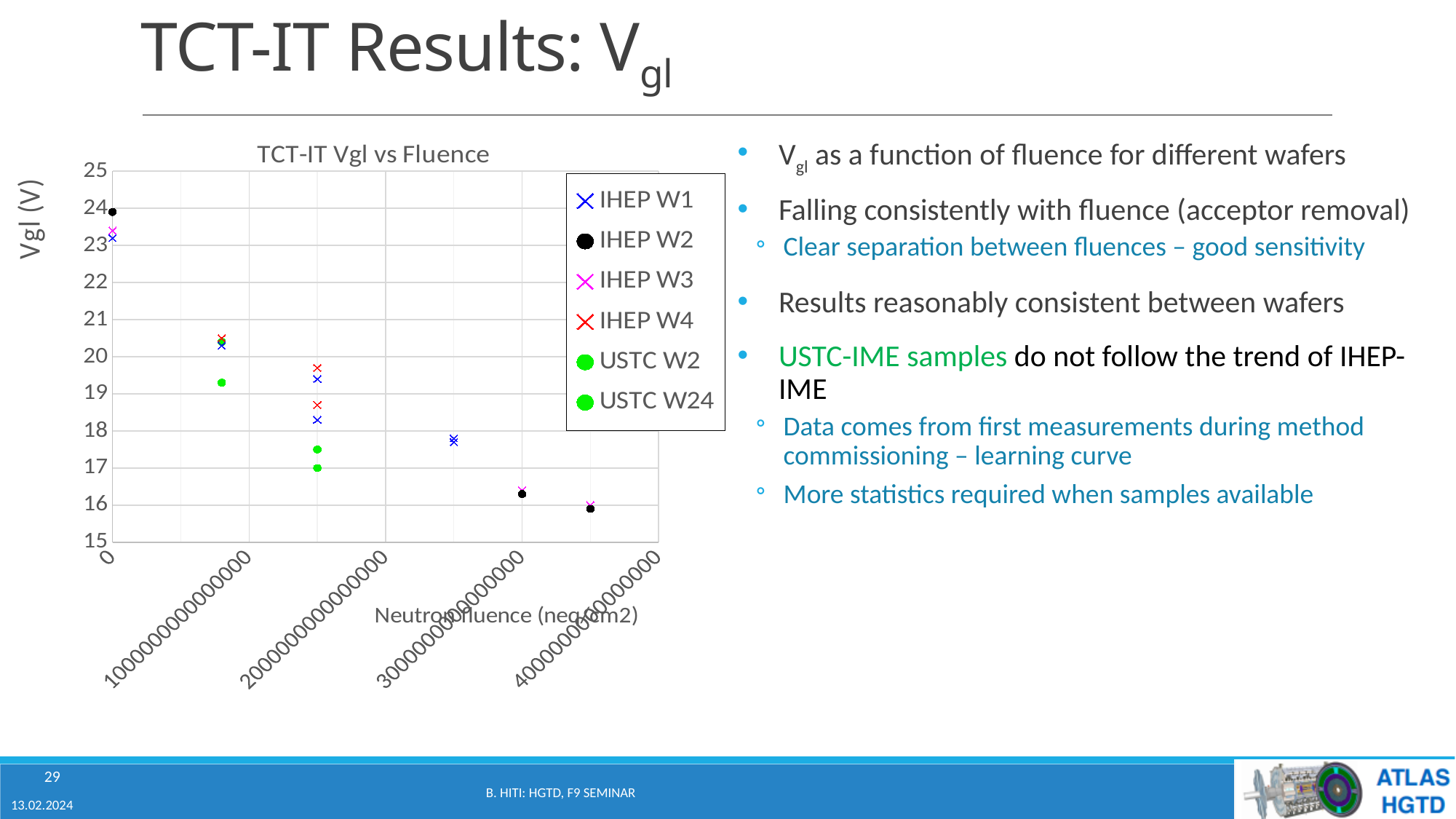
What is the title of the chart? TCT-IT Vgl vs Fluence Are the Vgl values plotted at the fluence of 3000000000000000 greater or less than 18? less Is the Vgl value for IHEP W4 at the fluence of 1000000000000000 greater or less than 20? greater What kind of chart is shown on the slide? scatter chart How many series does the legend of the chart list? 6 What is the label of the vertical axis of the chart? Vgl (V) Is the Vgl value for IHEP W2 at the fluence of 4000000000000000 greater or less than 17? less At zero fluence, which series has the higher Vgl value, IHEP W1 or IHEP W2? IHEP W2 Do the Vgl values rise or fall as the neutron fluence increases along the x axis? fall